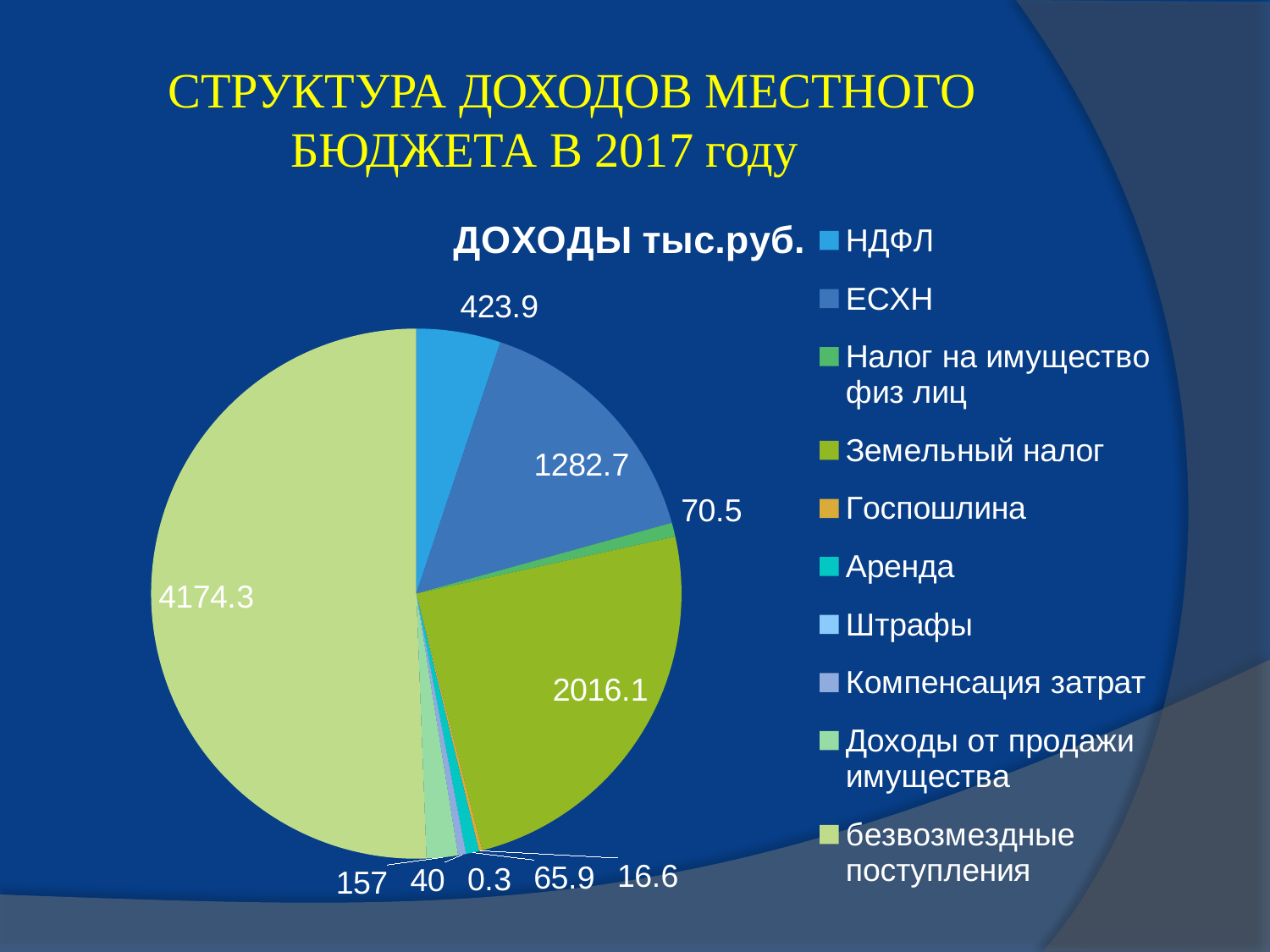
What is the value for безвозмездные поступления? 4174.3 What is the value for ЕСХН? 1282.7 Which category has the smallest slice of the pie? Штрафы What is the value for Налог на имущество физ лиц? 70.5 What is the title of the chart? ДОХОДЫ тыс.руб. What kind of chart is shown on the slide? pie chart What is the value for Земельный налог? 2016.1 Which is larger, ЕСХН or НДФЛ? ЕСХН Which category has the largest slice of the pie? безвозмездные поступления How many categories does the legend of the pie chart list? 10 What is the difference between безвозмездные поступления and Земельный налог? 2158.2 What is the value for НДФЛ? 423.9